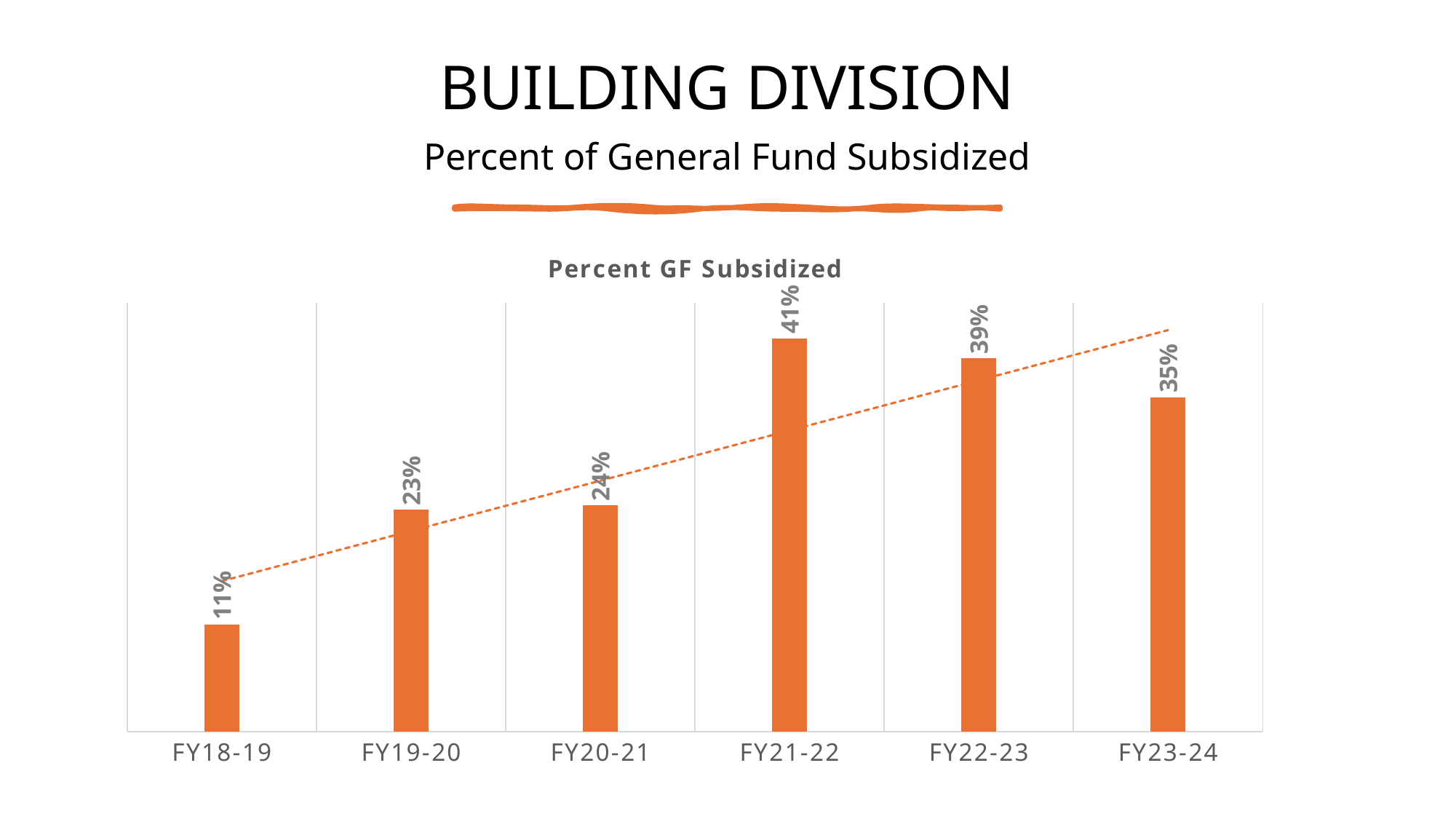
Which fiscal year has the highest percent GF subsidized? FY21-22 What is the value for FY21-22? 41% Which fiscal year has the lowest percent GF subsidized? FY18-19 What is the value for FY18-19? 11% What is the title of the chart? Percent GF Subsidized What kind of chart is shown on the slide? Bar chart Do the values generally rise or fall from FY18-19 to FY21-22? Rise What is the difference between the values for FY22-23 and FY23-24? 4% How many fiscal years are shown on the x axis? 6 What is the difference between the values for FY21-22 and FY18-19? 30% What is the value for FY23-24? 35% Which is larger, the value for FY19-20 or the value for FY23-24? FY23-24